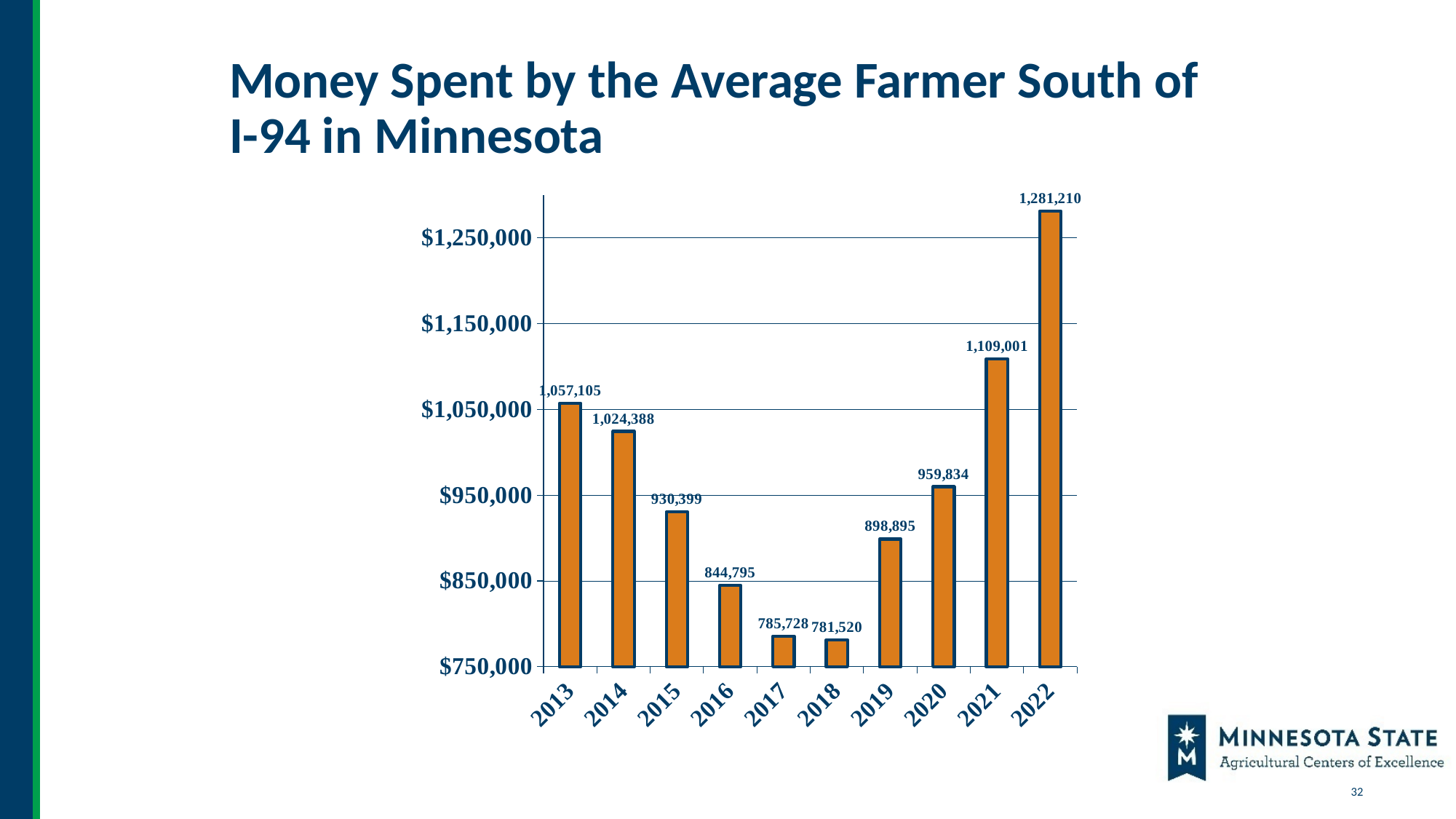
Which is larger, the value for 2015 or the value for 2020? 2020 What is the difference between the values for 2013 and 2014? 32,717 How many years are shown on the x axis? 10 Which year has the lowest value? 2018 What is the difference between the values for 2022 and 2021? 172,209 Do the values rise or fall from 2018 to 2022? rise Which year has the highest value? 2022 What is the value for 2022? 1,281,210 What is the value for 2019? 898,895 What kind of chart is shown on the slide? bar chart Is the value for 2021 greater or less than $1,050,000? greater What is the value for 2016? 844,795